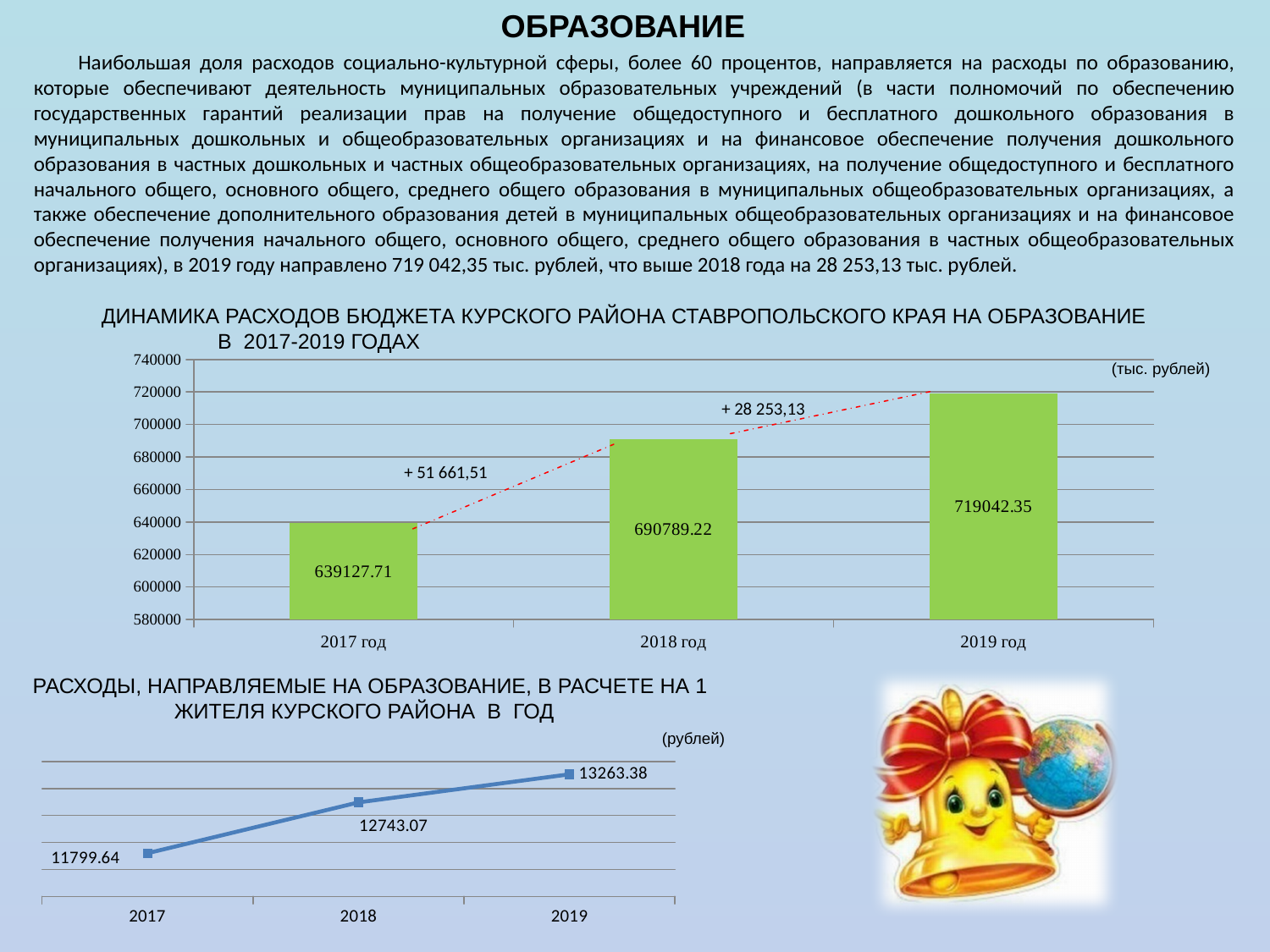
In the top chart (dynamics of education budget expenditures 2017-2019), which year has the lowest value? 2017 год In the top chart (dynamics of education budget expenditures 2017-2019), what unit is indicated in the upper right corner of the plot? тыс. рублей In the top chart (dynamics of education budget expenditures 2017-2019), what is the value for 2019 год? 719042.35 In the top chart (dynamics of education budget expenditures 2017-2019), what kind of chart is shown? bar chart In the bottom chart (education expenditures per 1 resident per year), which year has the highest value? 2019 In the bottom chart (education expenditures per 1 resident per year), what is the difference between the 2018 and 2017 values? 943.43 In the top chart (dynamics of education budget expenditures 2017-2019), what is the difference between the 2019 год and 2018 год values? 28253.13 In the bottom chart (education expenditures per 1 resident per year), what is the value for 2019? 13263.38 In the top chart (dynamics of education budget expenditures 2017-2019), do the values rise or fall from 2017 to 2019? rise In the top chart (dynamics of education budget expenditures 2017-2019), what is the value for 2018 год? 690789.22 In the bottom chart (education expenditures per 1 resident per year), what is the value for 2017? 11799.64 In the bottom chart (education expenditures per 1 resident per year), how many data points are plotted? 3